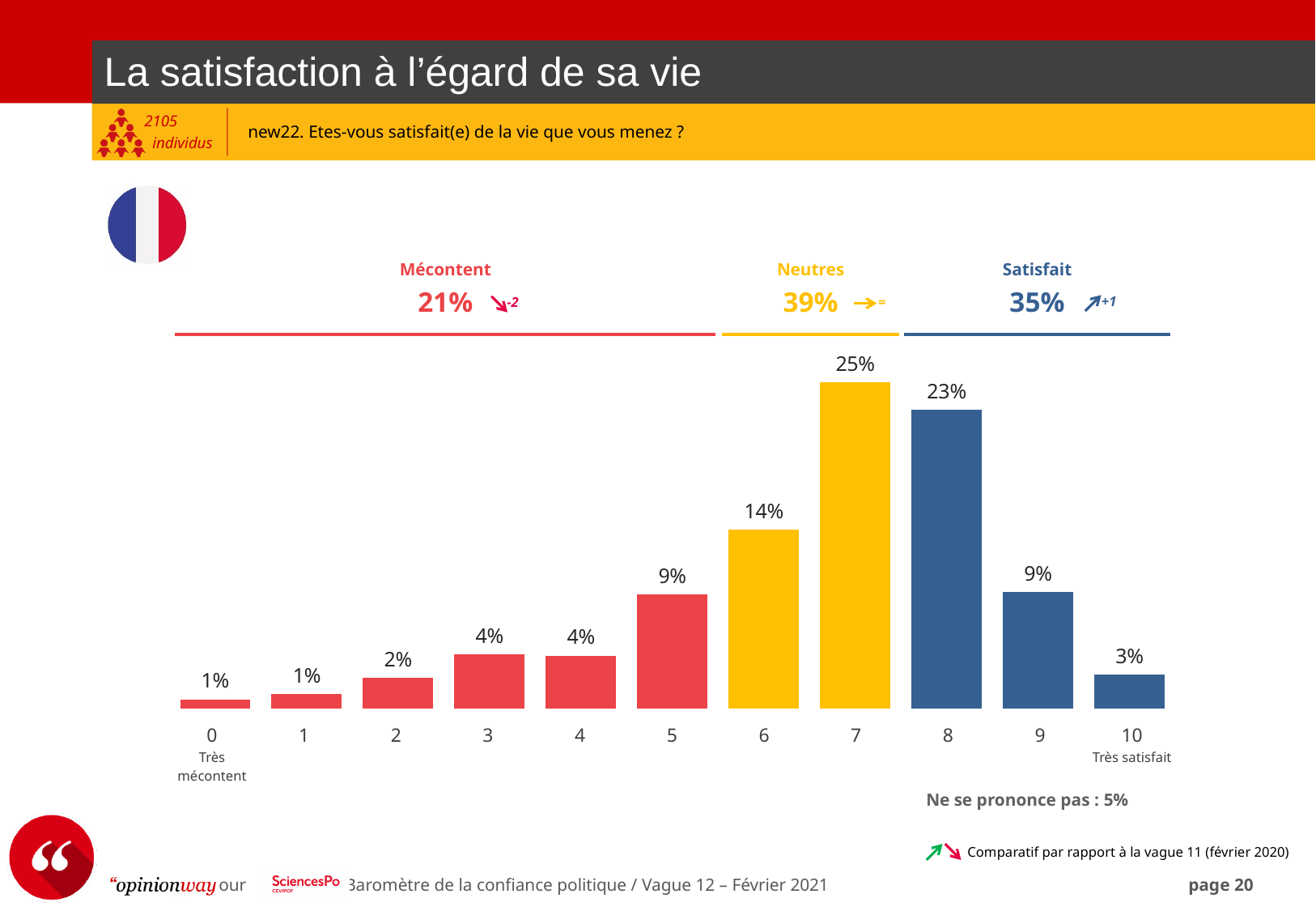
What percentage of respondents gave a score of 3? 4% What colour are the bars for scores 6 and 7? Yellow How many score categories are shown on the x axis? 11 What is the combined percentage for the 'Satisfait' group? 35% What percentage of respondents gave a score of 7? 25% Which has a larger percentage, score 6 or score 5? 6 What kind of chart is shown on the slide? Bar chart What is the label under score 10 on the x axis? Très satisfait Which score has the highest percentage of respondents? 7 What percentage of respondents did not answer ('Ne se prononce pas')? 5% What is the combined percentage for the 'Mécontent' group (scores 0 to 5)? 21% What is the difference between the percentage for score 8 and the percentage for score 9? 14%